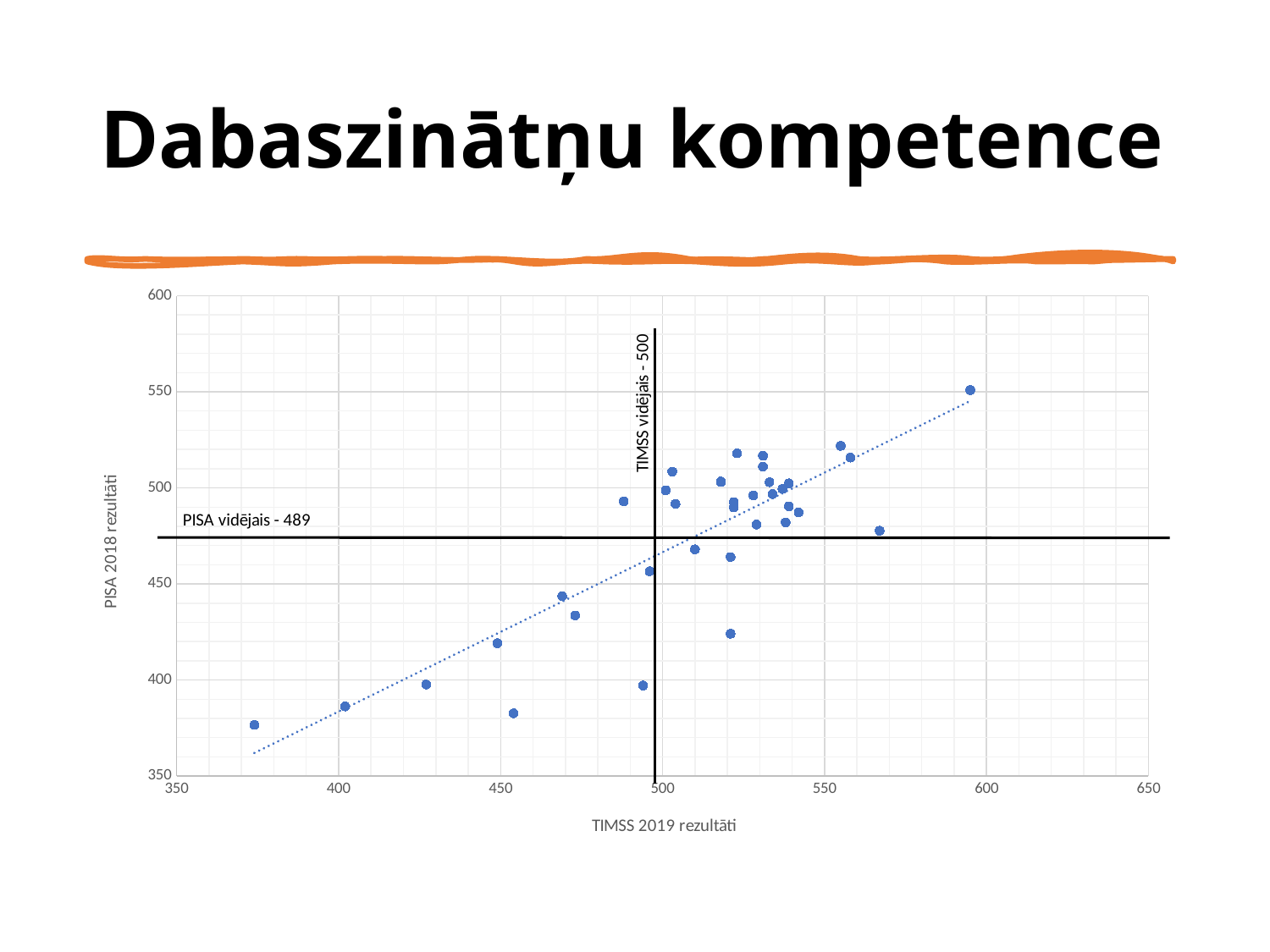
What PISA average value is marked by the horizontal reference line? 489 Is the TIMSS 2019 value of the rightmost point greater or less than 550? greater Do PISA 2018 values generally rise or fall as TIMSS 2019 values increase? rise What kind of chart is shown on the slide? scatter chart What is the title of the vertical (y) axis? PISA 2018 rezultāti What is the difference between the TIMSS average (500) and the PISA average (489) marked on the chart? 11 Is the PISA 2018 value of the point with the highest TIMSS 2019 score greater or less than 500? greater Is the PISA 2018 value of the lowest point on the chart greater or less than 400? less Which is larger, the TIMSS average marked on the chart or the PISA average marked on the chart? TIMSS average (500) What is the title of the horizontal (x) axis? TIMSS 2019 rezultāti What TIMSS average value is marked by the vertical reference line? 500